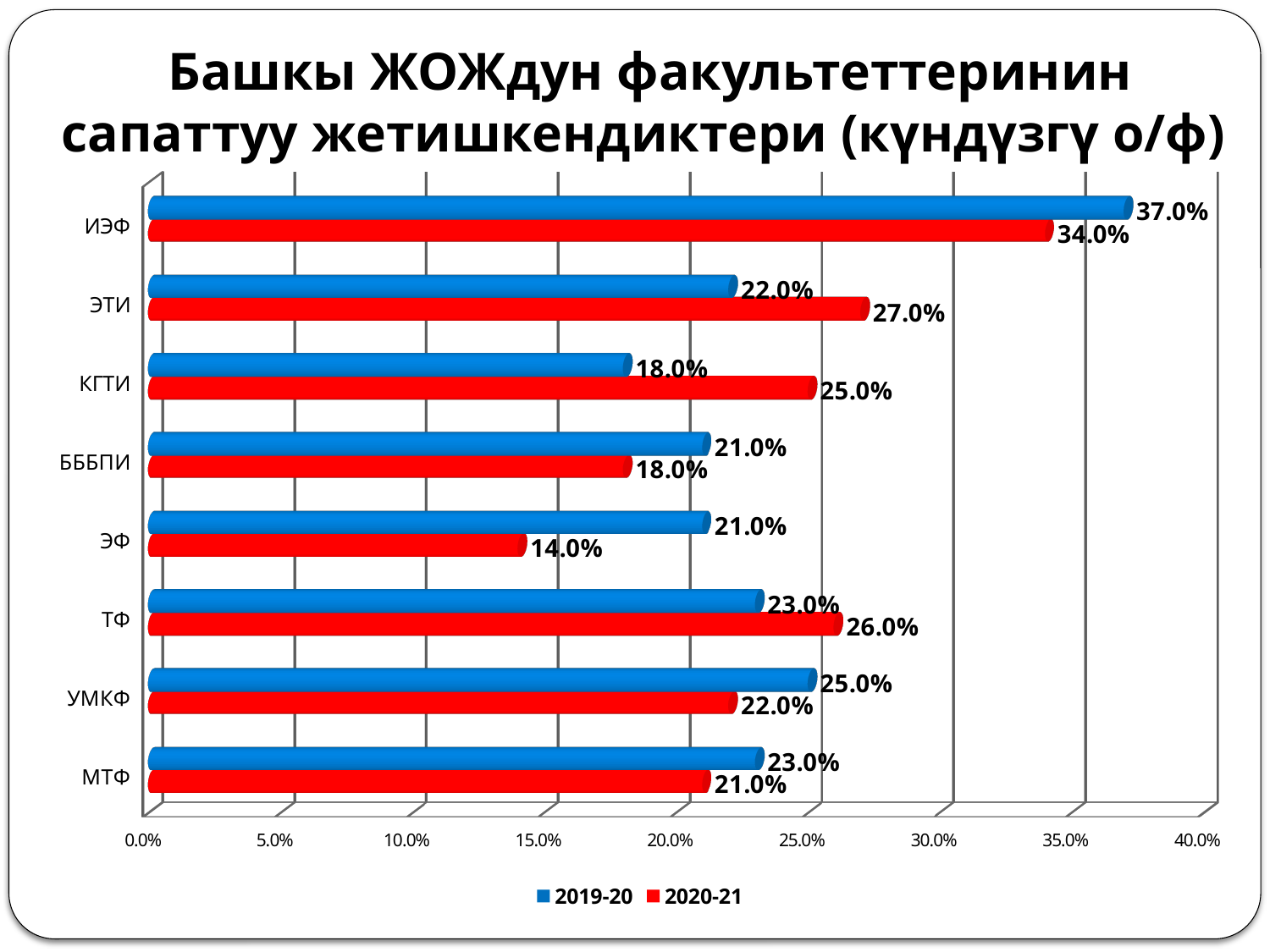
Which is larger for ТФ: the 2019-20 value or the 2020-21 value? 2020-21 Which colour represents the 2020-21 series? red What is the 2020-21 value for ЭФ? 14.0% Which category has the lowest 2020-21 value? ЭФ What is the 2019-20 value for ИЭФ? 37.0% How many series does the legend list? 2 What is the 2020-21 value for КГТИ? 25.0% Which category has the lowest 2019-20 value? КГТИ Which category has the highest 2020-21 value? ИЭФ What kind of chart is shown on the slide? bar chart What is the difference between the 2019-20 and 2020-21 values for ЭТИ? 5.0% How many categories are shown on the chart? 8